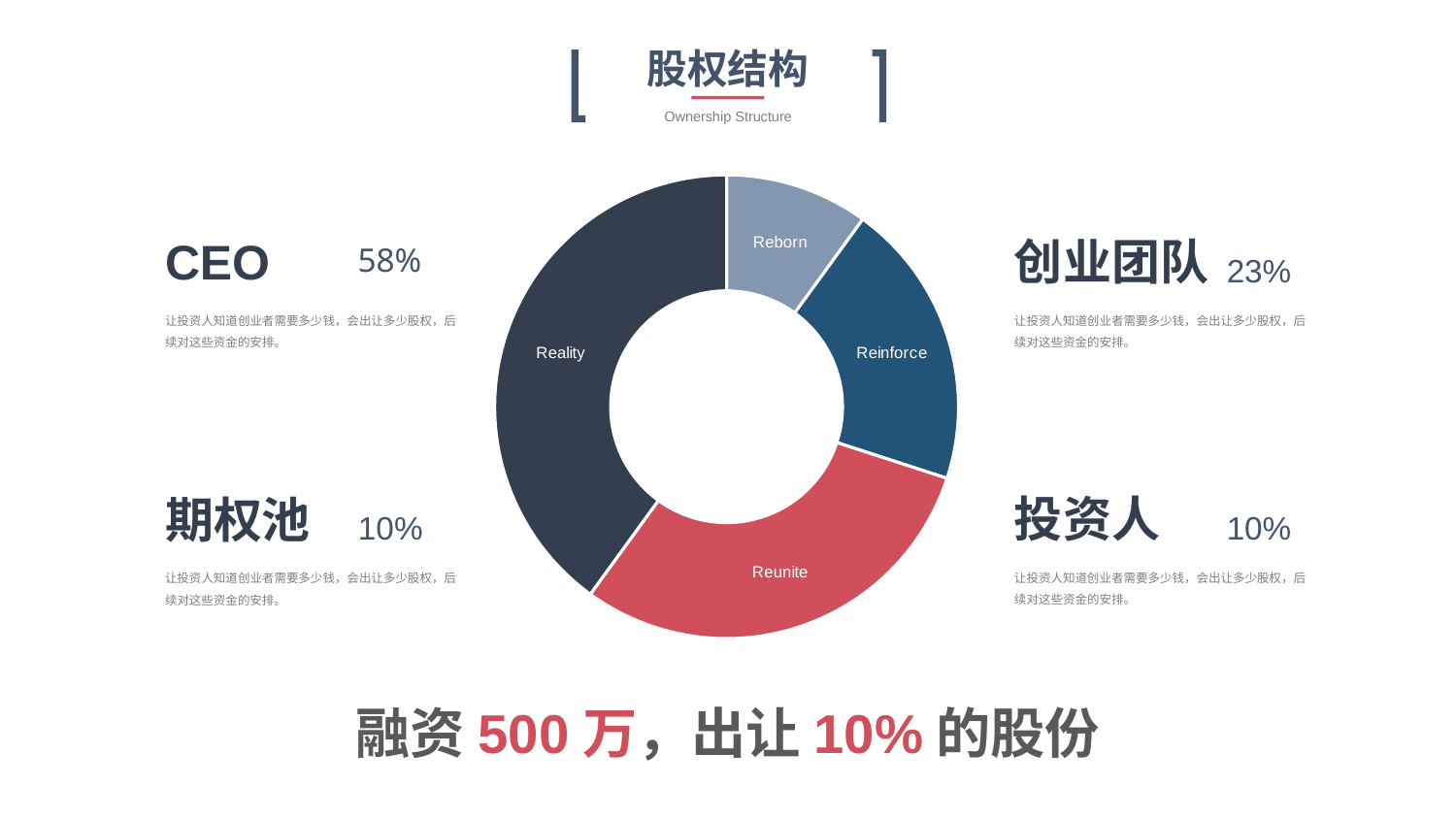
How many segments does the donut chart have? 4 What is the English subtitle shown under the chart title? Ownership Structure Which segment is larger, Reality or Reborn? Reality Which segment is larger, Reunite or Reinforce? Reunite Which segment is larger, Reinforce or Reborn? Reinforce What kind of chart is shown on the slide? Donut (pie) chart Which segment of the donut chart is the smallest? Reborn What is the Chinese title shown above the chart? 股权结构 Which segment of the donut chart is the largest? Reality